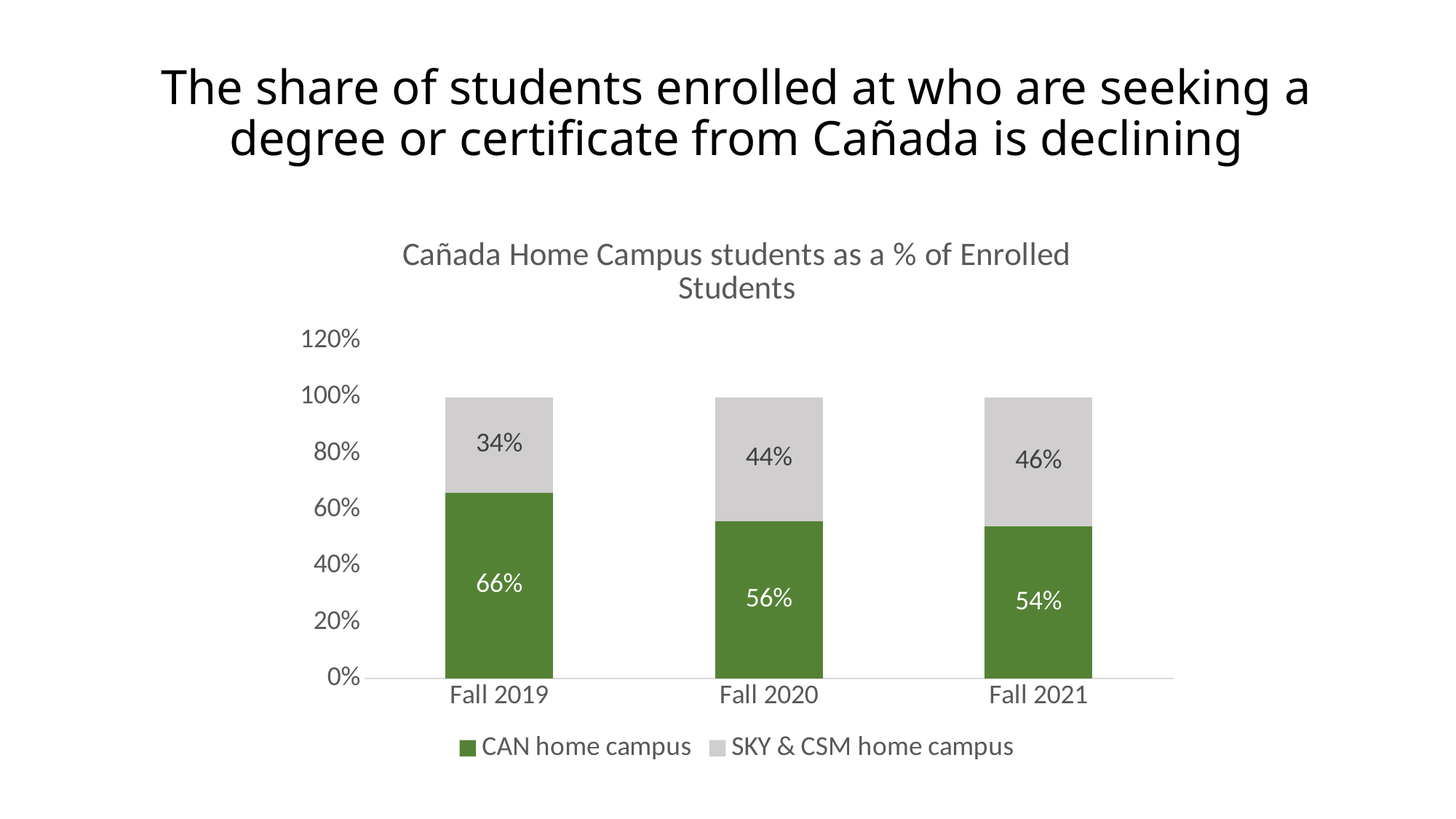
How many terms are shown on the x axis? 3 Does the CAN home campus share rise or fall from Fall 2019 to Fall 2021? Fall Which is larger in Fall 2020: the CAN home campus share or the SKY & CSM home campus share? CAN home campus How many series does the legend list? 2 In which term is the SKY & CSM home campus share lowest? Fall 2019 What is the value for SKY & CSM home campus in Fall 2021? 46% What is the value for CAN home campus in Fall 2020? 56% What kind of chart is shown? Stacked bar chart In which term is the CAN home campus share highest? Fall 2019 What is the value for CAN home campus in Fall 2019? 66% What is the difference between the CAN home campus share in Fall 2019 and Fall 2021? 12% What is the title of the chart? Cañada Home Campus students as a % of Enrolled Students